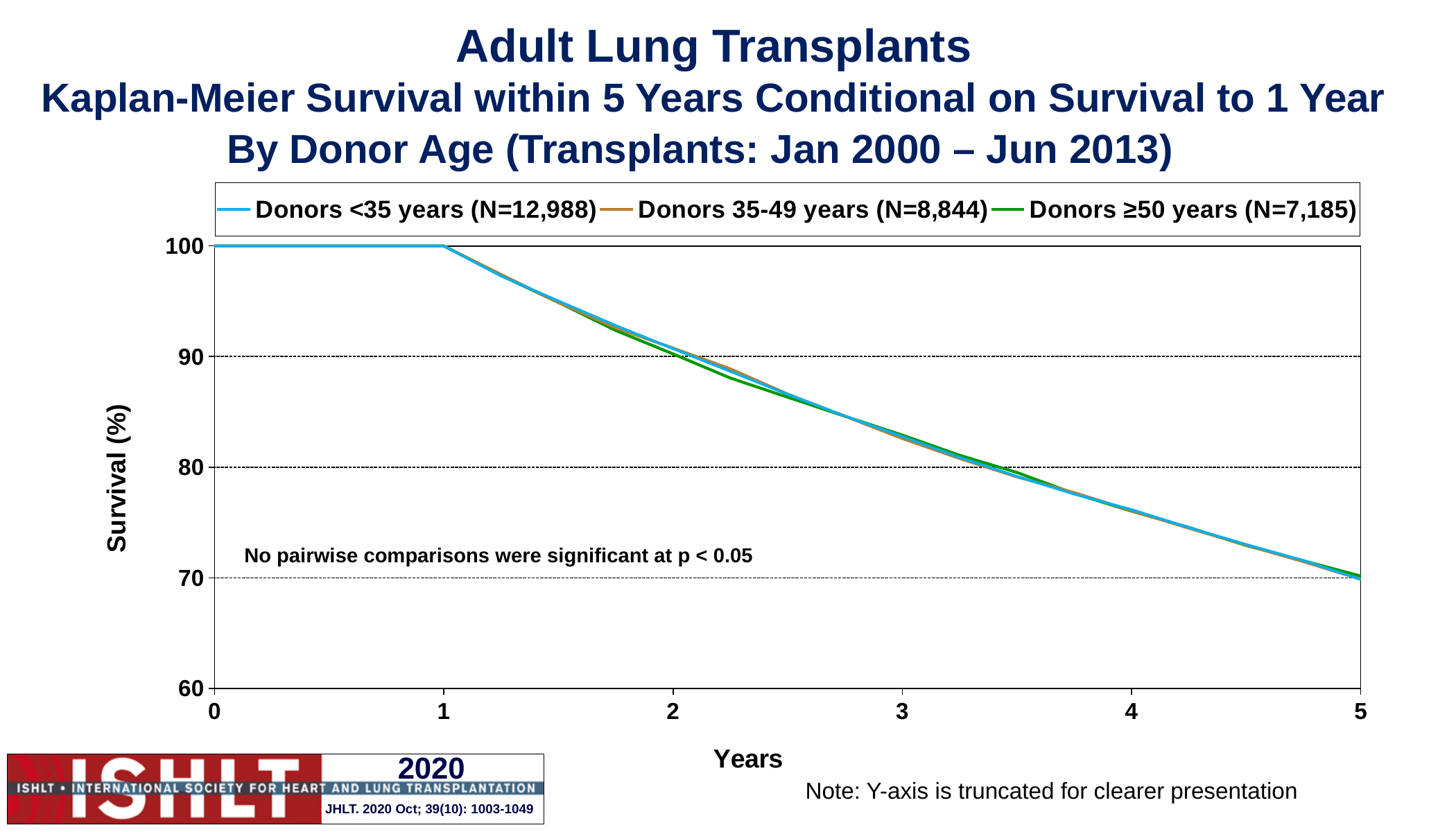
What is the survival value for Donors ≥50 years at year 0? 100 Is the survival value for Donors ≥50 years at year 4 greater or less than 80? less What is the label of the y axis? Survival (%) How many series does the legend list? 3 Is the survival value for Donors <35 years at year 3 greater or less than 80? greater Is the survival value for Donors 35-49 years at year 3 greater or less than 90? less What is the N shown in the legend for Donors <35 years? N=12,988 Do the survival curves rise or fall along the x axis after year 1? fall What kind of chart is shown on the slide? line chart What is the survival value for Donors <35 years at year 1? 100